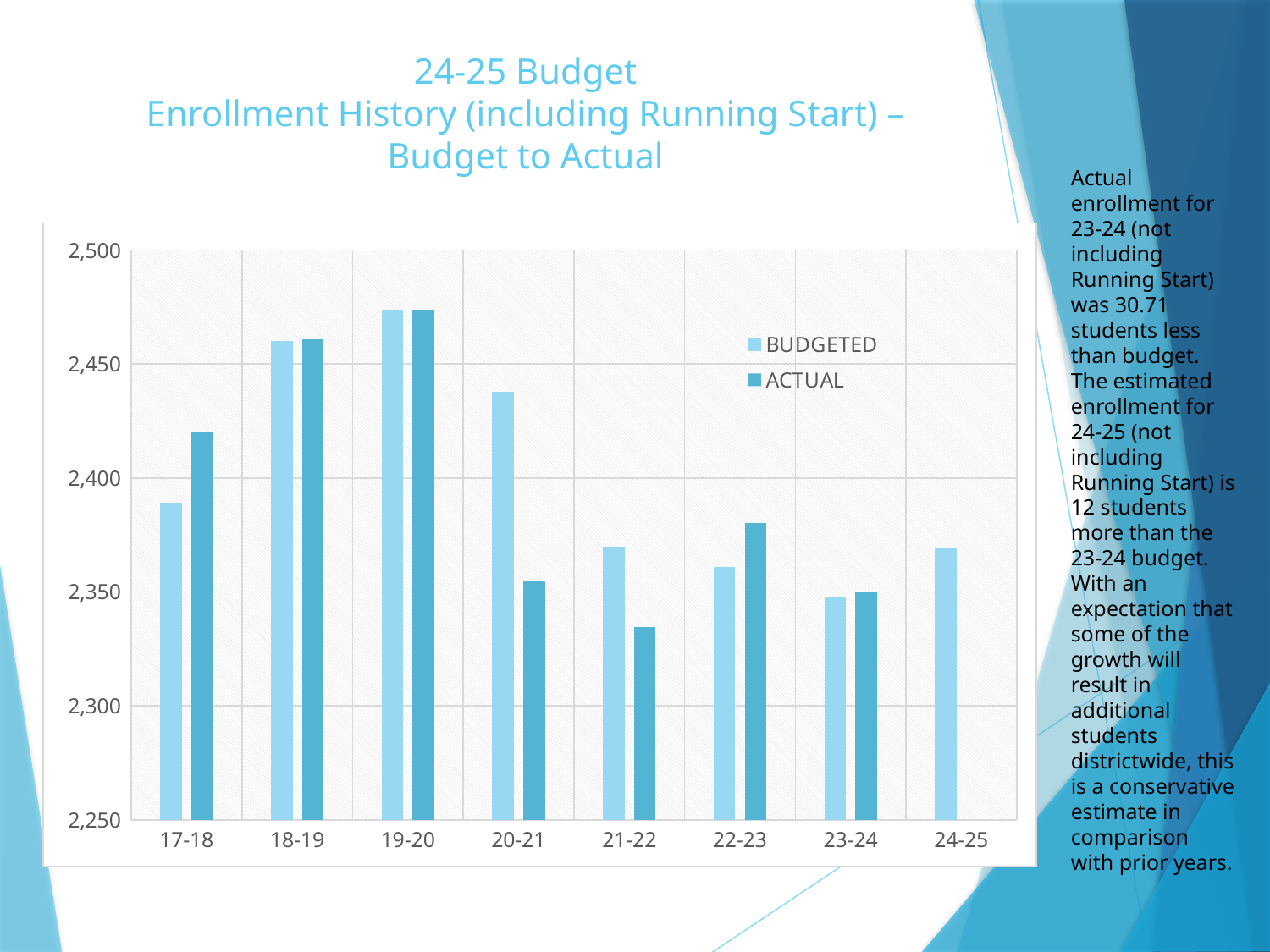
How many school-year categories are shown on the x axis? 8 For 20-21, which is larger, the BUDGETED or the ACTUAL enrollment? BUDGETED Is the ACTUAL value for 17-18 greater or less than 2,400? greater Is the BUDGETED value for 20-21 greater or less than 2,450? less Which school year has the lowest ACTUAL enrollment? 21-22 Which school year on the x axis has no ACTUAL bar? 24-25 Is the ACTUAL value for 21-22 greater or less than 2,350? less For 22-23, which is larger, the BUDGETED or the ACTUAL enrollment? ACTUAL Which school year has the highest BUDGETED enrollment? 19-20 How many series does the legend list? 2 What kind of chart is shown on the slide? bar chart